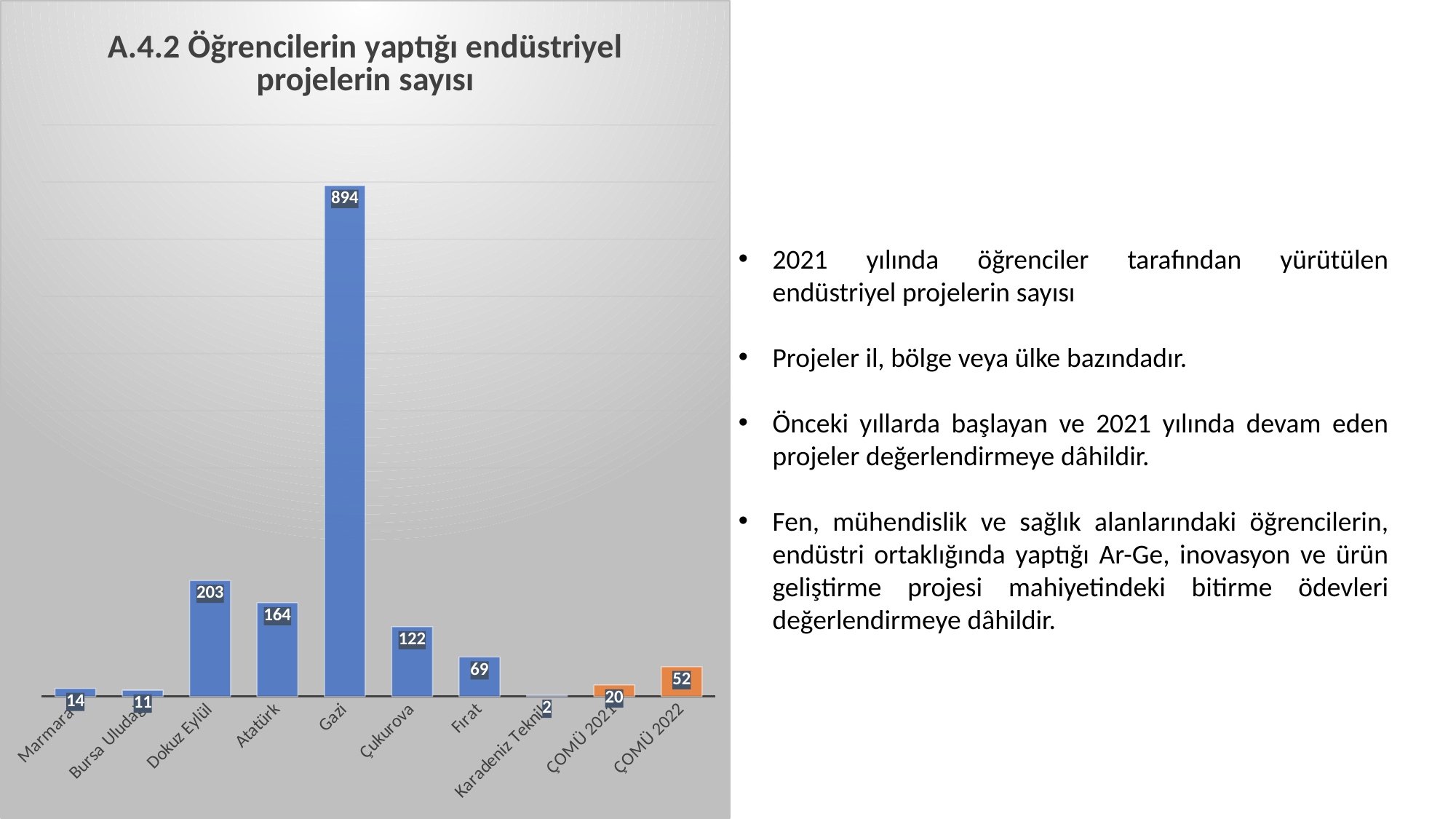
What is the title of the chart? A.4.2 Öğrencilerin yaptığı endüstriyel projelerin sayısı What is the value for Dokuz Eylül? 203 What kind of chart is shown on the slide? Bar chart Which category has the lowest value? Karadeniz Teknik What is the difference between the values for Dokuz Eylül and Atatürk? 39 What is the value for Gazi? 894 What is the value for ÇOMÜ 2022? 52 How many categories are shown on the x axis? 10 Which is larger, the value for Çukurova or the value for Fırat? Çukurova What is the difference between the values for ÇOMÜ 2022 and ÇOMÜ 2021? 32 What is the value for Karadeniz Teknik? 2 Which category has the highest value? Gazi